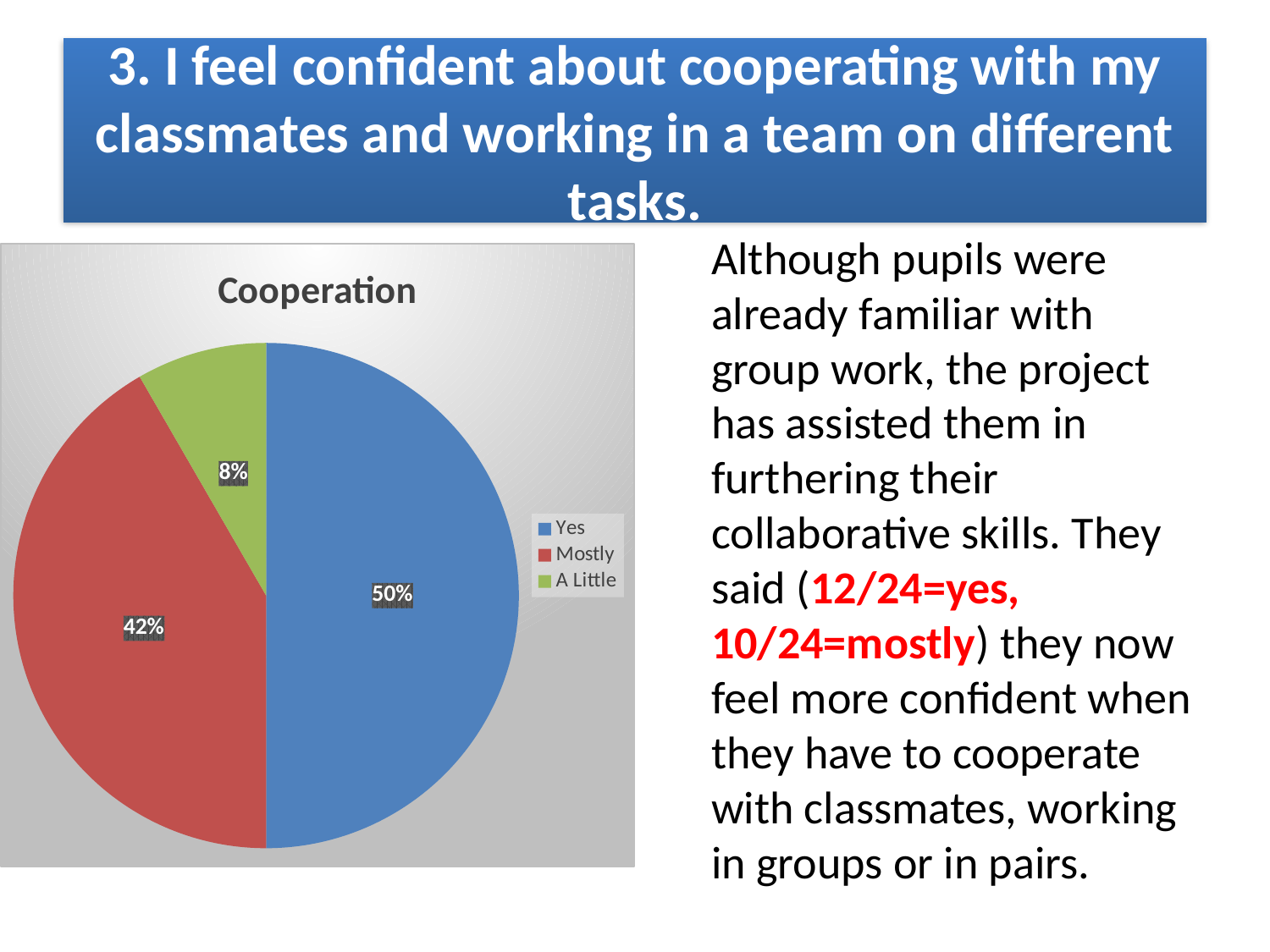
Which category has the smallest share of the pie? A Little Which category has the largest share of the pie? Yes What colour is the "Mostly" slice? red What percentage of the pie is the "A Little" slice? 8% What is the title of the chart? Cooperation What kind of chart is shown on the slide? pie chart How many categories does the pie chart have? 3 What percentage of the pie is the "Mostly" slice? 42% Which slice is larger, "Mostly" or "A Little"? Mostly What is the difference in percentage points between the "Mostly" and "A Little" slices? 34 What percentage of the pie is the "Yes" slice? 50% What is the difference in percentage points between the "Yes" and "Mostly" slices? 8